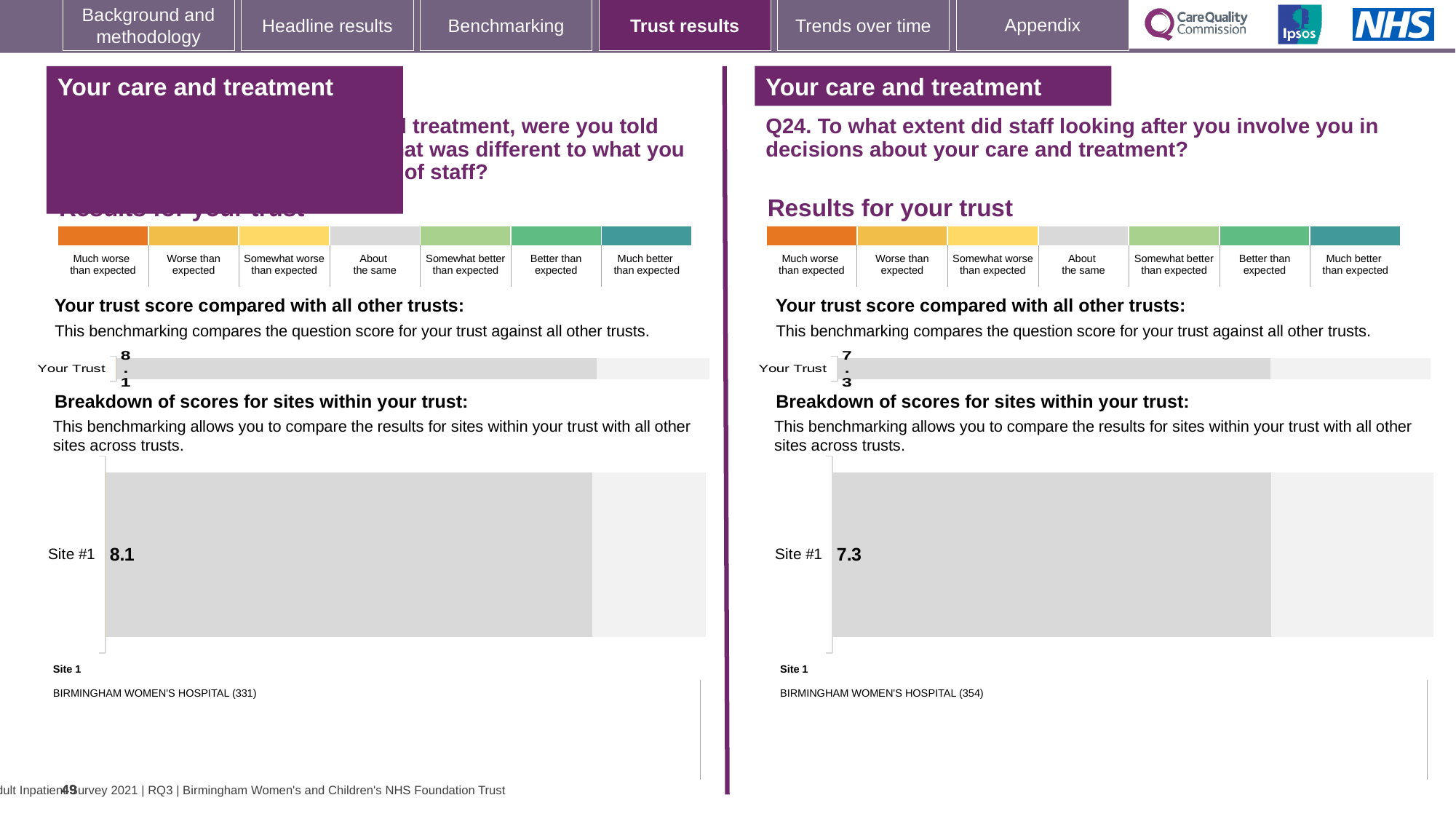
Which site is listed as Site 1 beneath the right (Q24) breakdown chart? BIRMINGHAM WOMEN'S HOSPITAL (354) How many sites are shown in the left 'Breakdown of scores for sites within your trust' chart? 1 What kind of chart is used for the 'Breakdown of scores for sites within your trust' on the left half of the slide? Bar chart On the right half of the slide (Q24), what is the score shown for Your Trust in the 'Your trust score compared with all other trusts' chart? 7.3 In the right (Q24) 'Breakdown of scores for sites within your trust' chart, what is the value for Site #1? 7.3 How many sites are shown in the right (Q24) 'Breakdown of scores for sites within your trust' chart? 1 Which site is listed as Site 1 beneath the left breakdown chart? BIRMINGHAM WOMEN'S HOSPITAL (331) On the left half of the slide, what is the score shown for Your Trust in the 'Your trust score compared with all other trusts' chart? 8.1 In the left 'Breakdown of scores for sites within your trust' chart, what is the value for Site #1? 8.1 What is the difference between the Site #1 score in the left breakdown chart and the Site #1 score in the right (Q24) breakdown chart? 0.8 Which is larger: the Your Trust score on the left half of the slide or the Your Trust score on the right half (Q24)? Left (8.1) What kind of chart is used to show the Your Trust score on the right half of the slide (Q24)? Bar chart